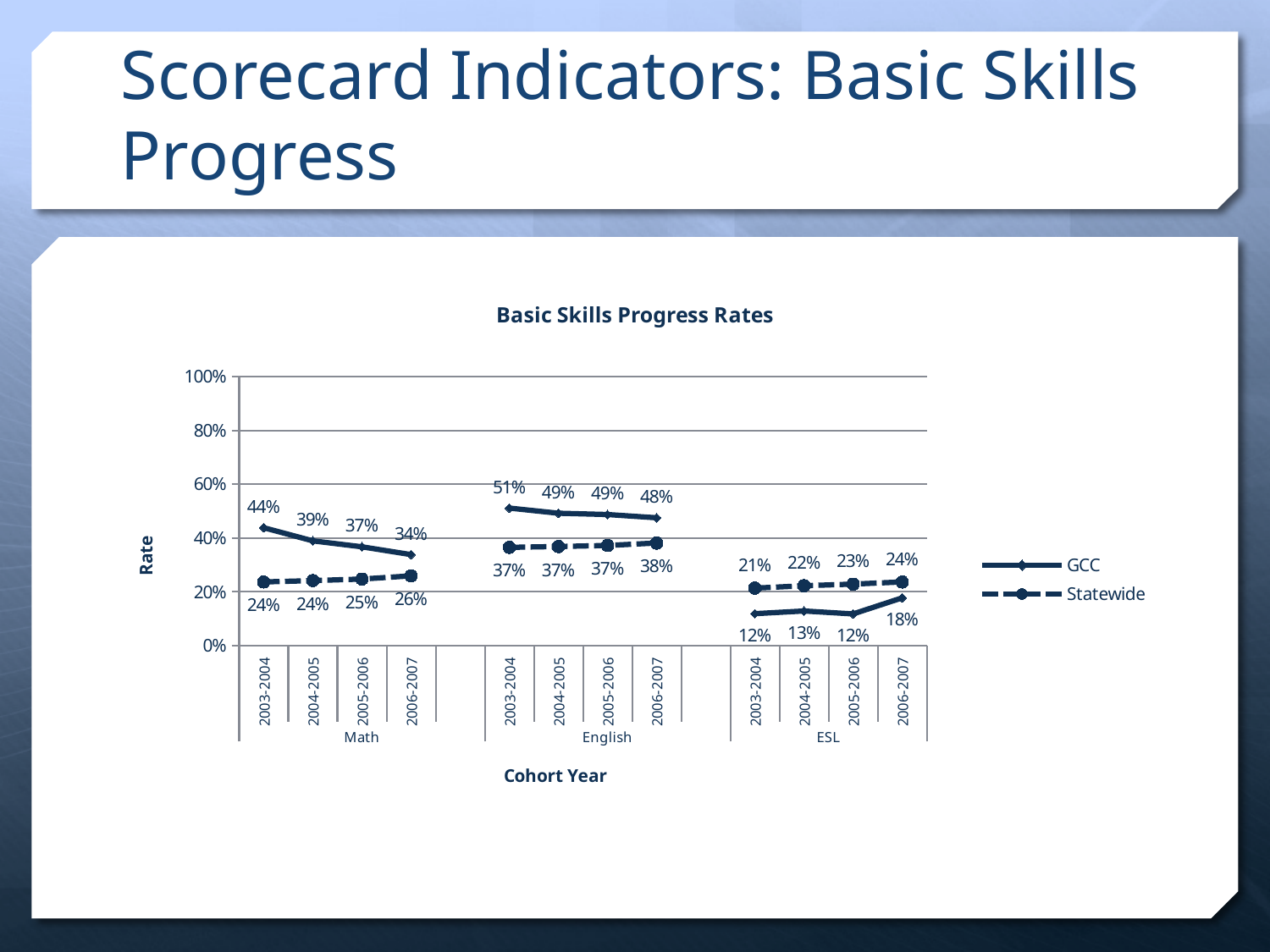
How many series does the legend list? 2 How many subject groups are shown on the x axis? 3 For ESL in 2004-2005, which is larger, the GCC rate or the Statewide rate? Statewide What is the title of the chart? Basic Skills Progress Rates What is the difference between the GCC and Statewide rates for Math in 2003-2004? 20 percentage points Which subject and cohort year has the highest GCC rate? English, 2003-2004 What is the GCC Basic Skills Progress rate for Math in 2003-2004? 44% Do the GCC Math rates rise or fall from 2003-2004 to 2006-2007? Fall What is the GCC rate for ESL in 2006-2007? 18% What is the Statewide rate for English in 2006-2007? 38% Which subject and cohort year has the lowest GCC rate? ESL, 2003-2004 and 2005-2006 What kind of chart is shown? Line chart